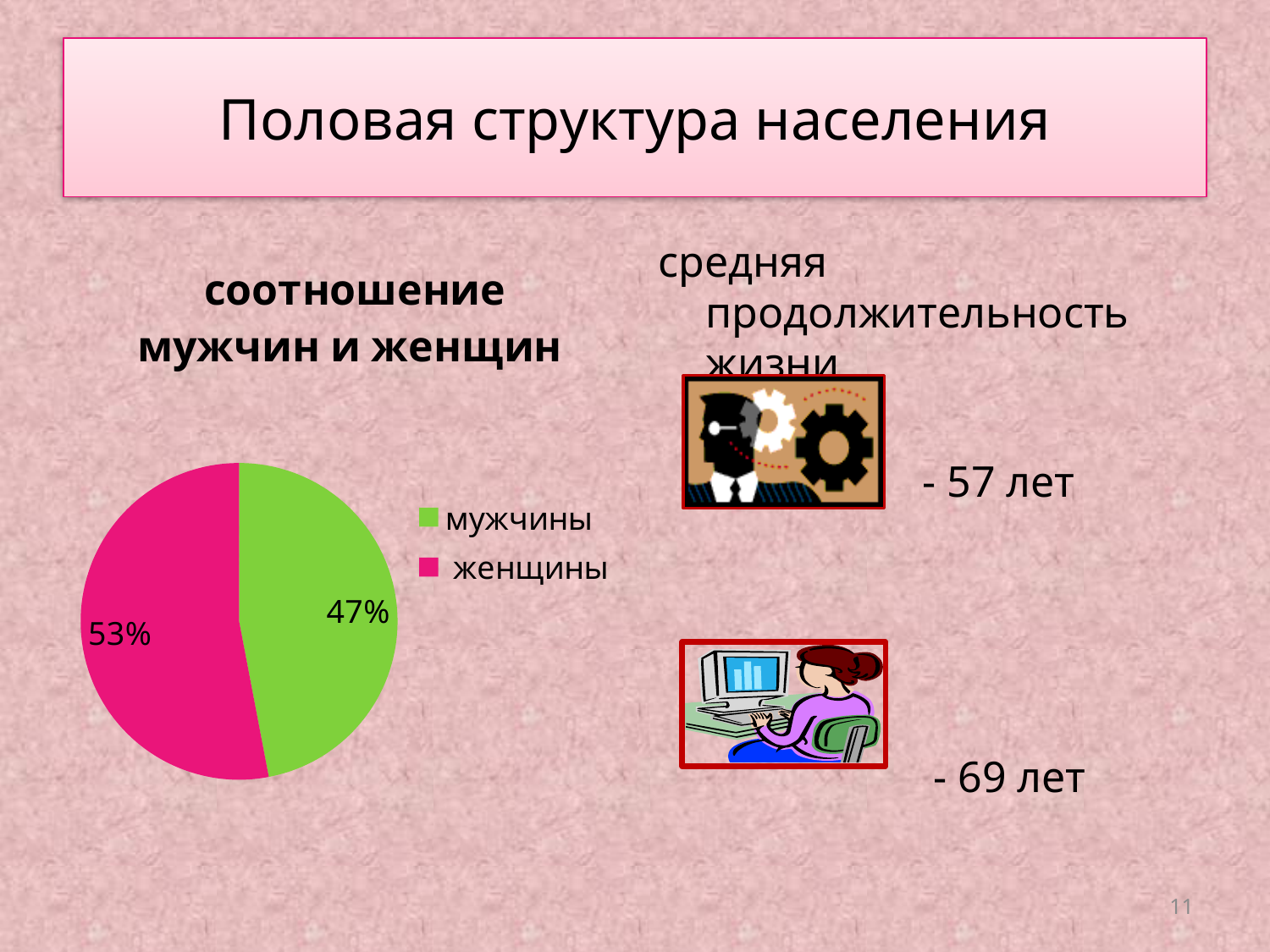
What share of the pie chart is labelled женщины? 53% What colour is the мужчины slice in the pie chart? green What type of chart is shown on the slide? pie chart Which slice of the pie chart is the largest? женщины How many entries does the chart legend list? 2 Which slice is larger, мужчины or женщины? женщины How many slices does the pie chart have? 2 What share of the pie chart is labelled мужчины? 47% Which slice of the pie chart is the smallest? мужчины What is the title of the chart? соотношение мужчин и женщин What is the difference in percentage points between the женщины and мужчины slices? 6